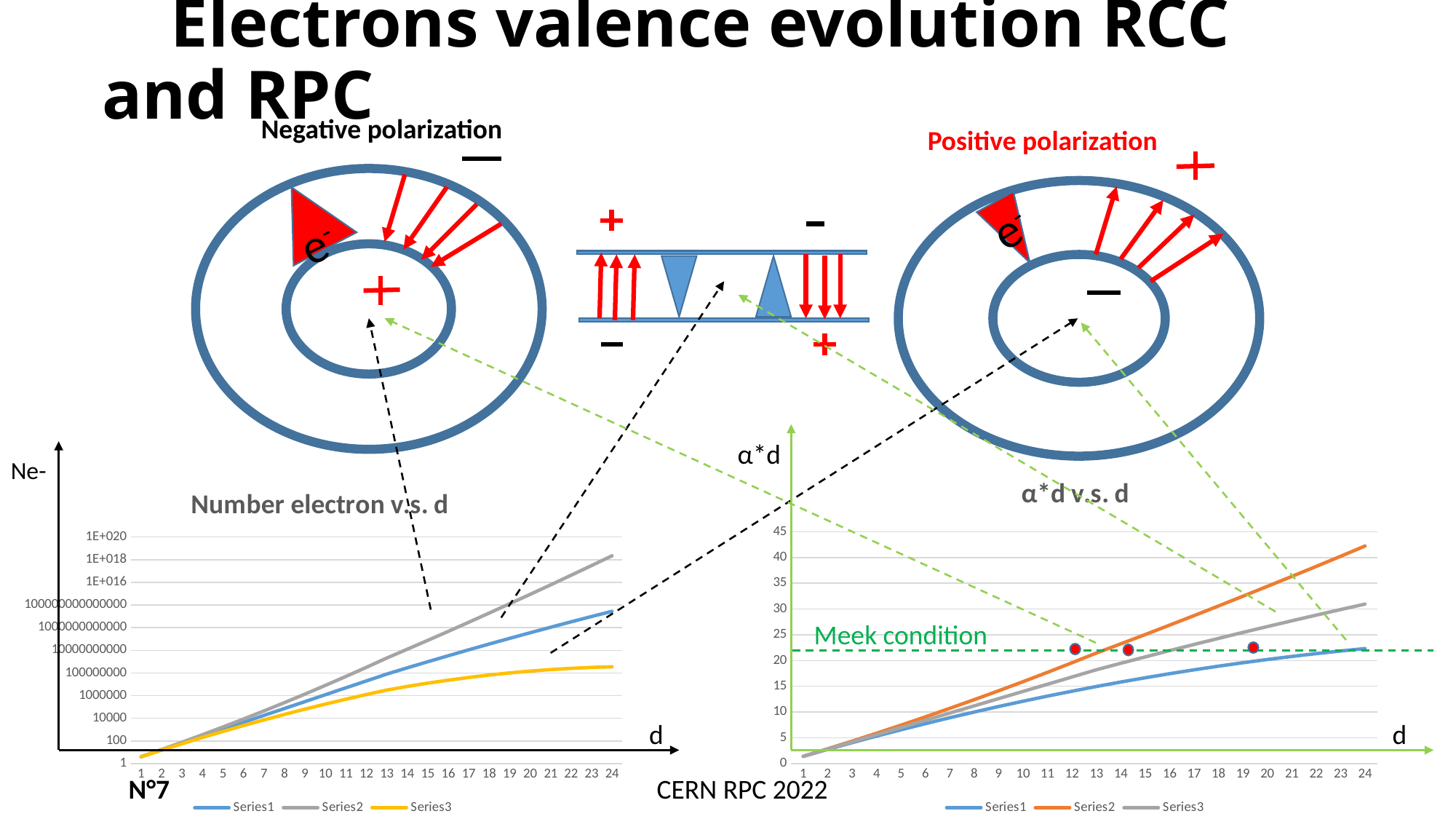
In the "α*d v.s. d" chart, which series has the highest value at d = 24? Series2 In the "α*d v.s. d" chart, is the value of Series1 at d = 24 greater or less than 25? less In the "α*d v.s. d" chart, does Series2 rise or fall as d increases? rise In the "Number electron v.s. d" chart, is the value of Series2 at d = 24 greater or less than 1E+016? greater In the "α*d v.s. d" chart, which series has the lowest value at d = 24? Series1 What is the label of the dashed green horizontal line in the "α*d v.s. d" chart? Meek condition What kind of chart is the "Number electron v.s. d" chart on the left? line chart In the "Number electron v.s. d" chart, which series is highest at d = 24? Series2 In the "α*d v.s. d" chart, is the value of Series2 at d = 24 greater or less than 40? greater How many series does the legend of the "α*d v.s. d" chart list? 3 In the "Number electron v.s. d" chart, which series is lowest at d = 24? Series3 How many points are on the x axis of the "Number electron v.s. d" chart? 24